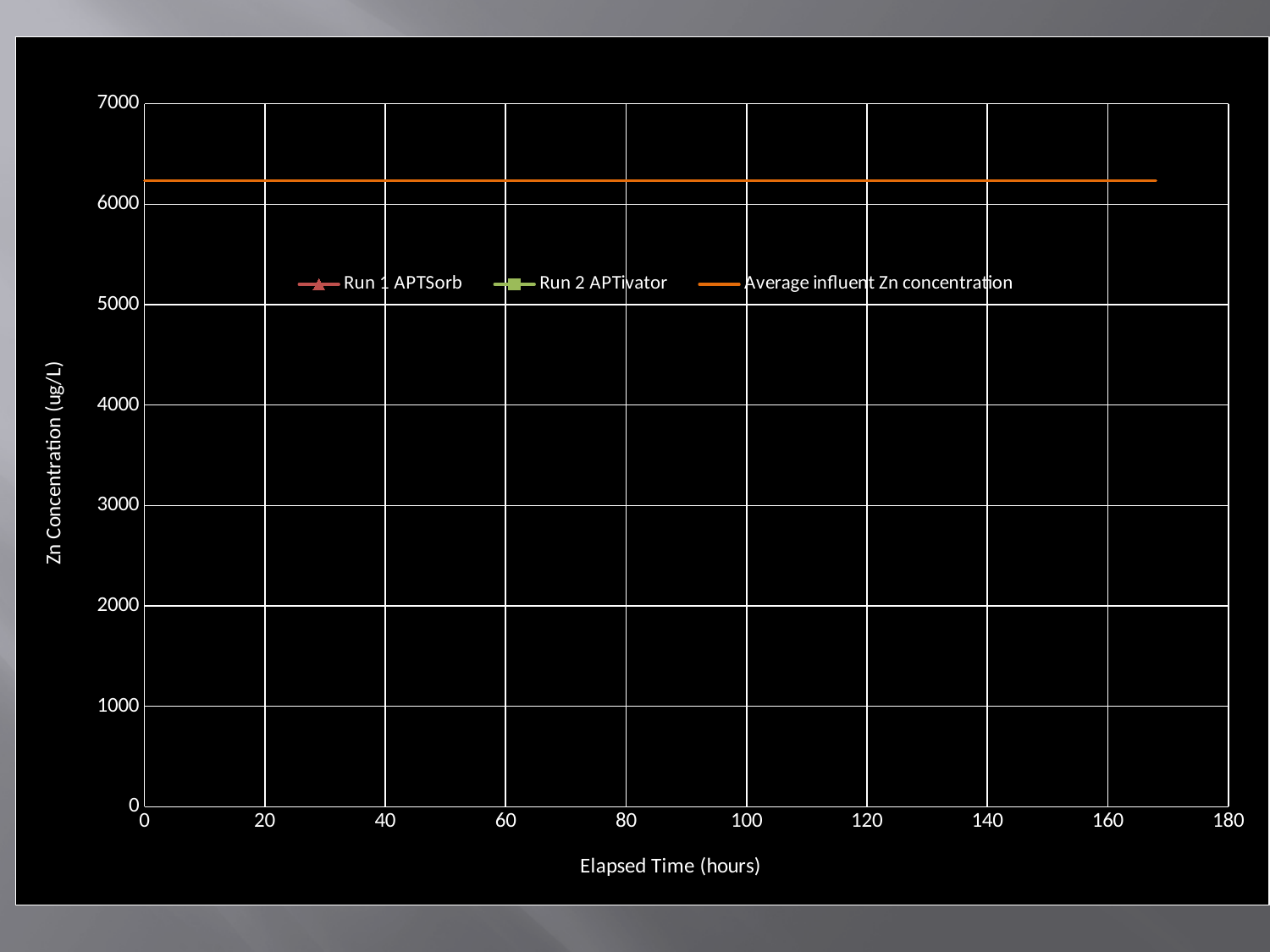
How many series does the legend list? 3 Does the Average influent Zn concentration line rise, fall, or stay flat as elapsed time increases? stays flat What is the title of the y axis? Zn Concentration (ug/L) Is the Average influent Zn concentration line greater or less than 5000? greater Is the Average influent Zn concentration line greater or less than 7000? less What kind of chart is shown on the slide? line chart Is the Average influent Zn concentration line greater or less than 6000? greater What is the title of the x axis? Elapsed Time (hours)